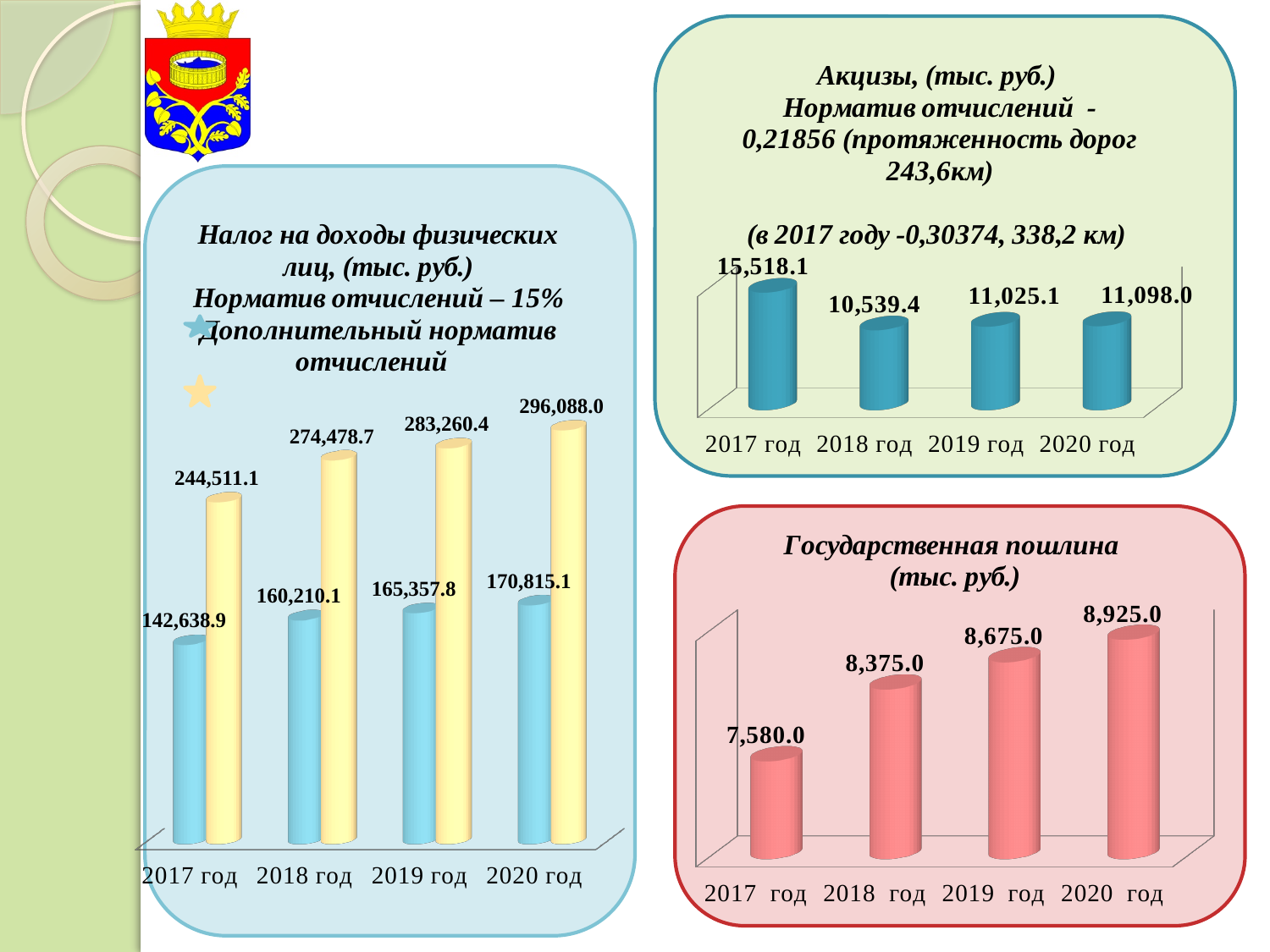
What type of chart is the 'Государственная пошлина' chart? bar chart In the 'Государственная пошлина' chart, what is the value for 2018 год? 8,375.0 In the 'Акцизы' chart, what is the value for 2019 год? 11,025.1 In the 'Налог на доходы физических лиц' chart, do the blue bars rise or fall from 2017 год to 2020 год? rise In the 'Акцизы' chart, which year has the highest value? 2017 год In the 'Акцизы' chart, what is the difference between the values for 2017 год and 2018 год? 4,978.7 In the 'Налог на доходы физических лиц' chart, what is the difference between the yellow and blue bars for 2019 год? 117,902.6 In the 'Налог на доходы физических лиц' chart, what is the value of the blue bar for 2017 год? 142,638.9 In the 'Налог на доходы физических лиц' chart, what is the value of the yellow bar for 2020 год? 296,088.0 In the 'Акцизы' chart, which year has the lowest value? 2018 год How many years are shown on the x axis of the 'Государственная пошлина' chart? 4 In the 'Государственная пошлина' chart, which is larger, the value for 2019 год or 2020 год? 2020 год